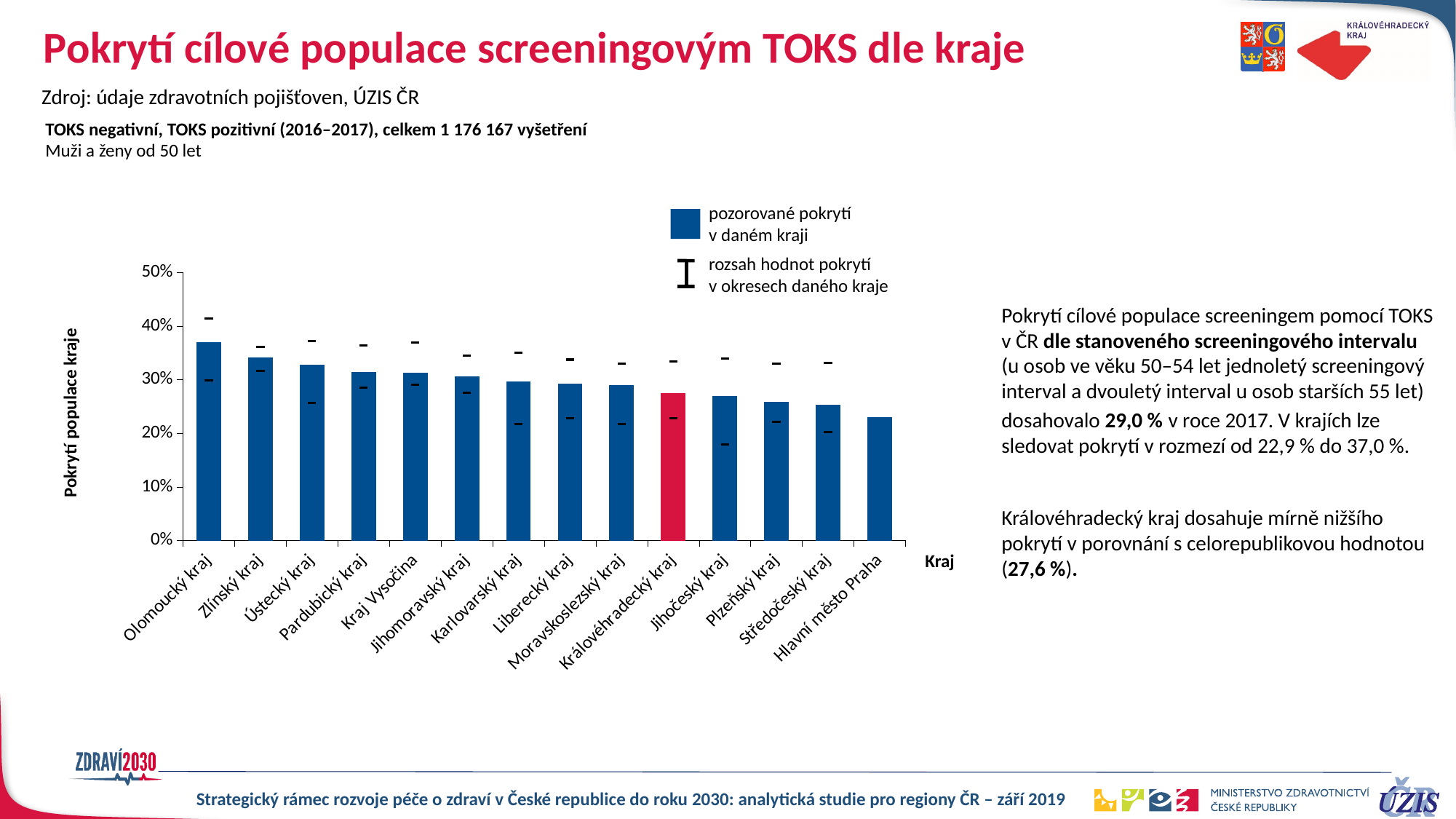
Which region has higher observed coverage, Ústecký kraj or Středočeský kraj? Ústecký kraj How many regions (kraje) are shown on the x axis of the chart? 14 What is the label of the y axis of the chart? Pokrytí populace kraje Is the observed coverage for Královéhradecký kraj greater or less than 30%? less Which region has the lowest observed coverage in the chart? Hlavní město Praha Which region has the highest observed coverage in the chart? Olomoucký kraj Which region's bar is highlighted in red in the chart? Královéhradecký kraj Is the observed coverage for Olomoucký kraj greater or less than 30%? greater Do the bar values rise or fall moving from left to right along the x axis? fall What kind of chart is shown on the slide? bar chart Is the observed coverage for Zlínský kraj greater or less than 40%? less